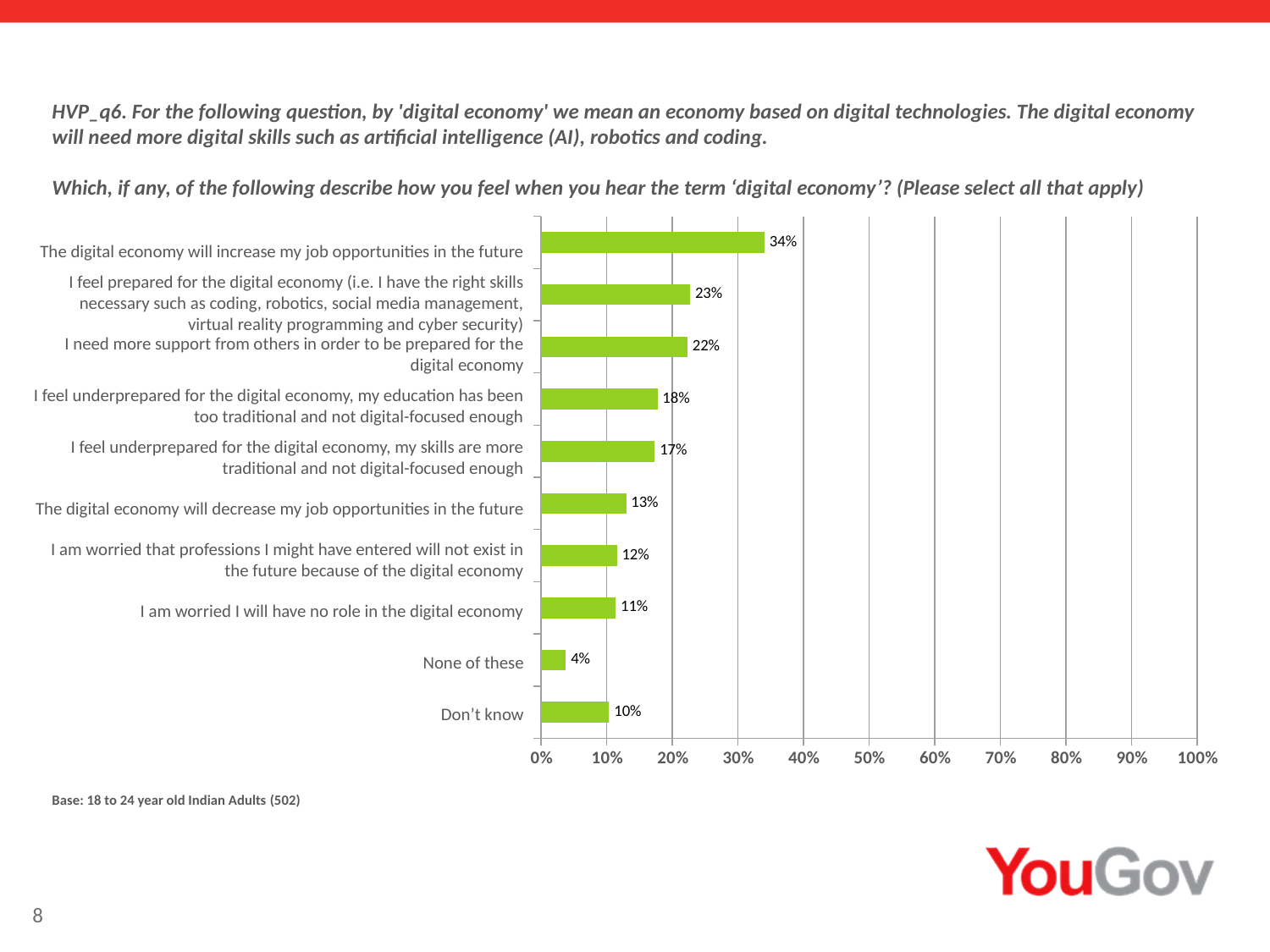
What percentage of respondents said they are worried they will have no role in the digital economy? 11% What is the maximum value shown on the horizontal axis? 100% Which response option has the highest percentage? The digital economy will increase my job opportunities in the future Which is larger: the percentage for 'I feel underprepared for the digital economy, my education has been too traditional and not digital-focused enough' or for 'I feel underprepared for the digital economy, my skills are more traditional and not digital-focused enough'? I feel underprepared for the digital economy, my education has been too traditional and not digital-focused enough Which response option has the lowest percentage? None of these What percentage of respondents answered 'Don't know'? 10% What is the difference in percentage points between 'The digital economy will increase my job opportunities in the future' and 'The digital economy will decrease my job opportunities in the future'? 21 percentage points What type of chart is shown on the slide? Bar chart How many response options are shown in the chart? 10 What percentage of respondents said the digital economy will increase their job opportunities in the future? 34% Is the value for 'I need more support from others in order to be prepared for the digital economy' greater or less than 30%? less What is the base described below the chart? 18 to 24 year old Indian Adults (502)